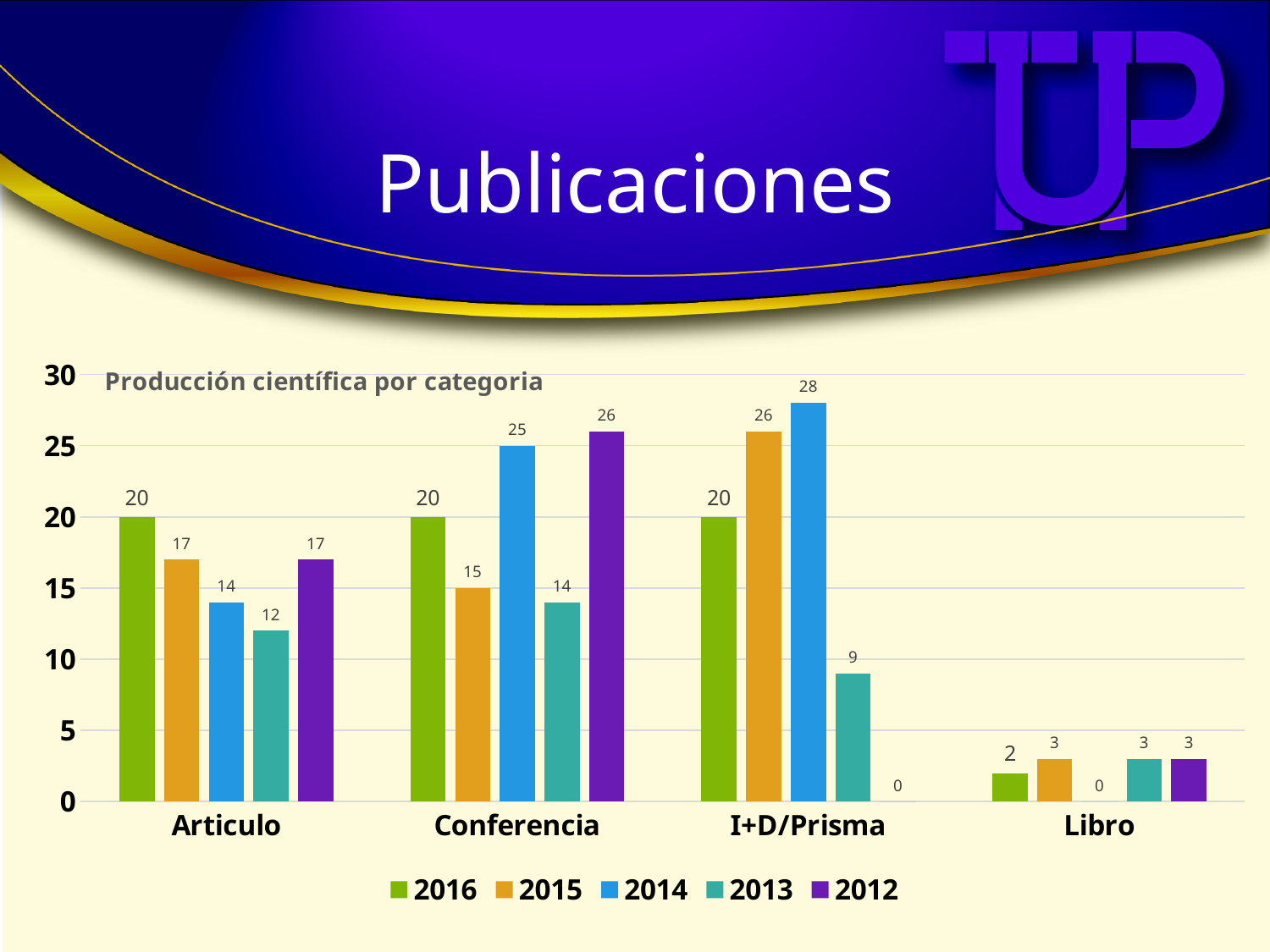
Which year has the lowest value in the Articulo category? 2013 What is the title of the chart? Producción científica por categoria How many categories are shown on the x axis? 4 Which year has the highest value in the I+D/Prisma category? 2014 What is the value for 2014 in the Conferencia category? 25 What is the value for 2013 in the I+D/Prisma category? 9 What is the value for 2012 in the Libro category? 3 What kind of chart is shown on the slide? Bar chart What is the difference between the 2012 and 2013 values in the Conferencia category? 12 What is the value for 2012 in the I+D/Prisma category? 0 How many series does the legend list? 5 Which is larger in the Articulo category, the value for 2015 or the value for 2014? 2015